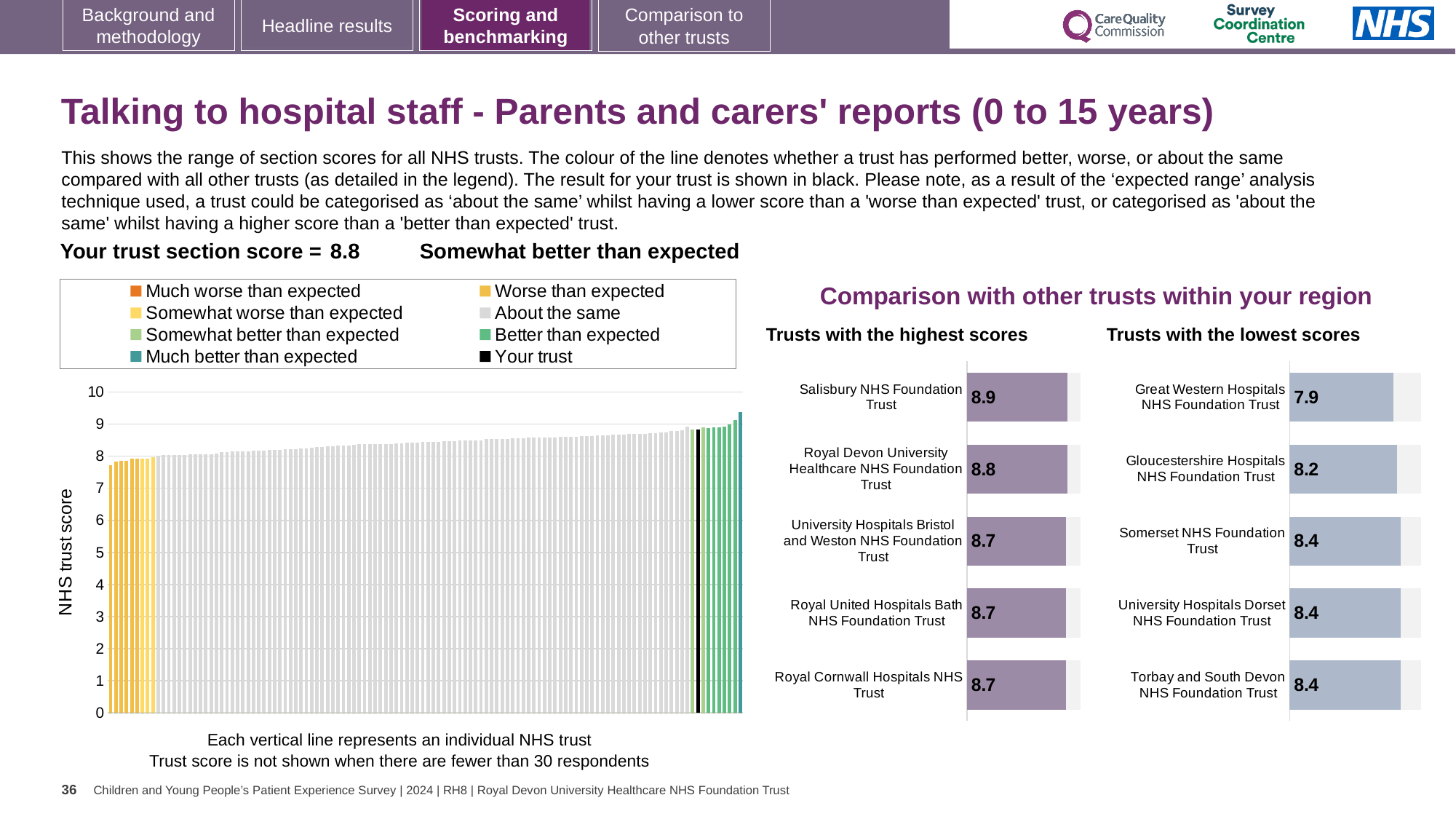
How many trusts are listed in the 'Trusts with the lowest scores' chart? 5 In the 'Trusts with the highest scores' chart, which has the larger score: Salisbury NHS Foundation Trust or Royal Cornwall Hospitals NHS Trust? Salisbury NHS Foundation Trust In the 'Trusts with the lowest scores' chart, what is the difference between the scores for Gloucestershire Hospitals NHS Foundation Trust and Great Western Hospitals NHS Foundation Trust? 0.3 What kind of chart is the main chart on the left with the 'NHS trust score' axis? Bar chart In the main 'NHS trust score' chart, do the bar heights rise or fall from left to right? Rise How many entries does the legend of the main 'NHS trust score' chart list? 8 In the 'Trusts with the highest scores' chart, which trust has the highest score? Salisbury NHS Foundation Trust In the 'Trusts with the lowest scores' chart, what is the score for Great Western Hospitals NHS Foundation Trust? 7.9 In the 'Trusts with the lowest scores' chart, which trust has the lowest score? Great Western Hospitals NHS Foundation Trust In the 'Trusts with the highest scores' chart, what is the score for Salisbury NHS Foundation Trust? 8.9 What is the section score for your trust shown on the slide? 8.8 What is the difference between the score for Salisbury NHS Foundation Trust in the 'Trusts with the highest scores' chart and the score for Great Western Hospitals NHS Foundation Trust in the 'Trusts with the lowest scores' chart? 1.0